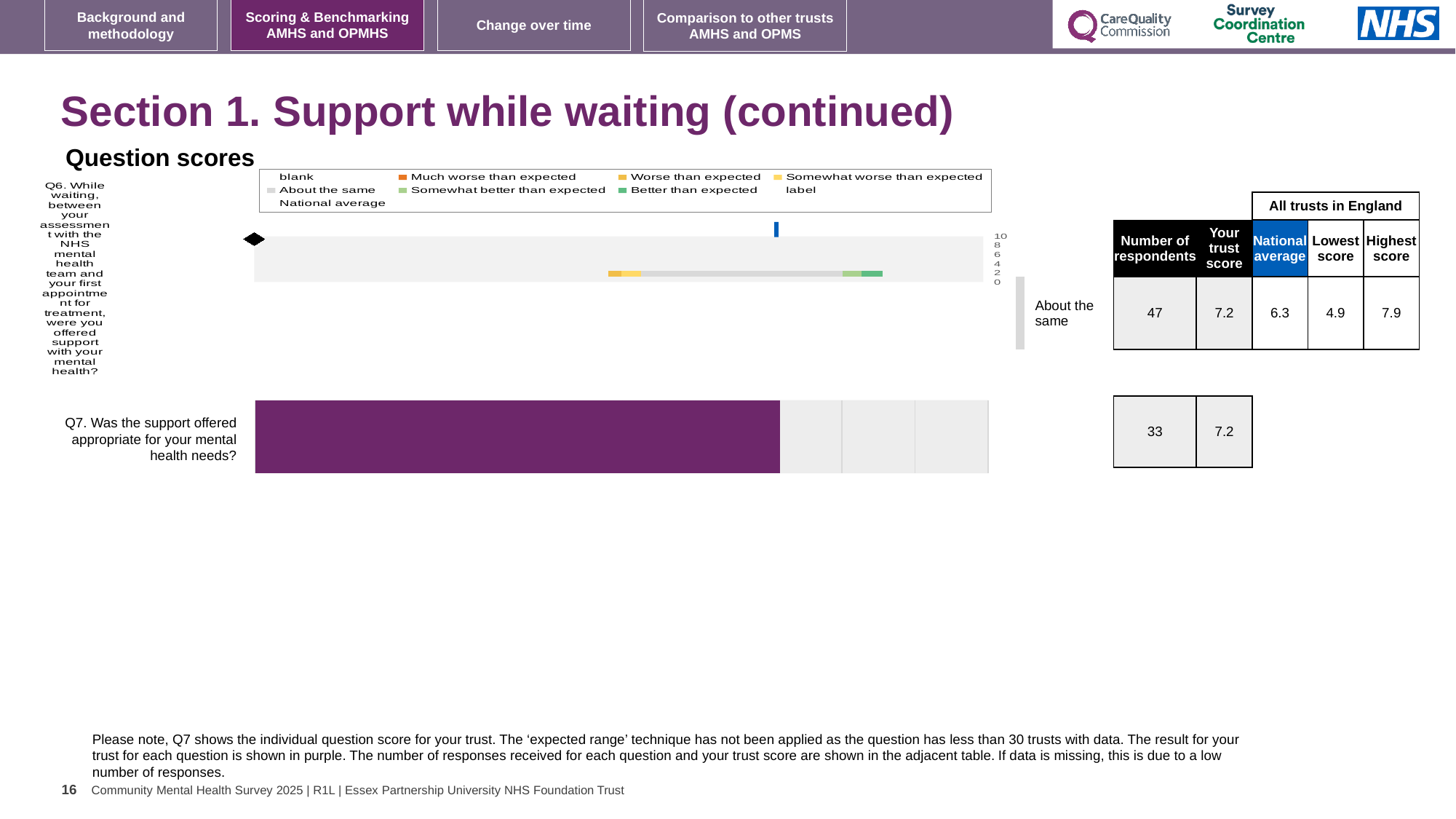
By how much does the trust score for Q6 exceed the national average for Q6? 0.9 What is the trust score for Q7? 7.2 Which question has more respondents, Q6 or Q7? Q6 What is the highest score among all trusts in England for Q6? 7.9 What is the national average score for Q6? 6.3 What category is the Q6 trust score placed in relative to the expected range? About the same What is the lowest score among all trusts in England for Q6? 4.9 What is the trust score for Q6? 7.2 Which is larger for Q6: the trust score or the national average? Trust score What is the difference between the highest and lowest scores for Q6 across all trusts in England? 3.0 How many respondents are shown for Q6 (While waiting, between your assessment with the NHS mental health team and your first appointment for treatment, were you offered support with your mental health?)? 47 How many respondents are shown for Q7 (Was the support offered appropriate for your mental health needs?)? 33